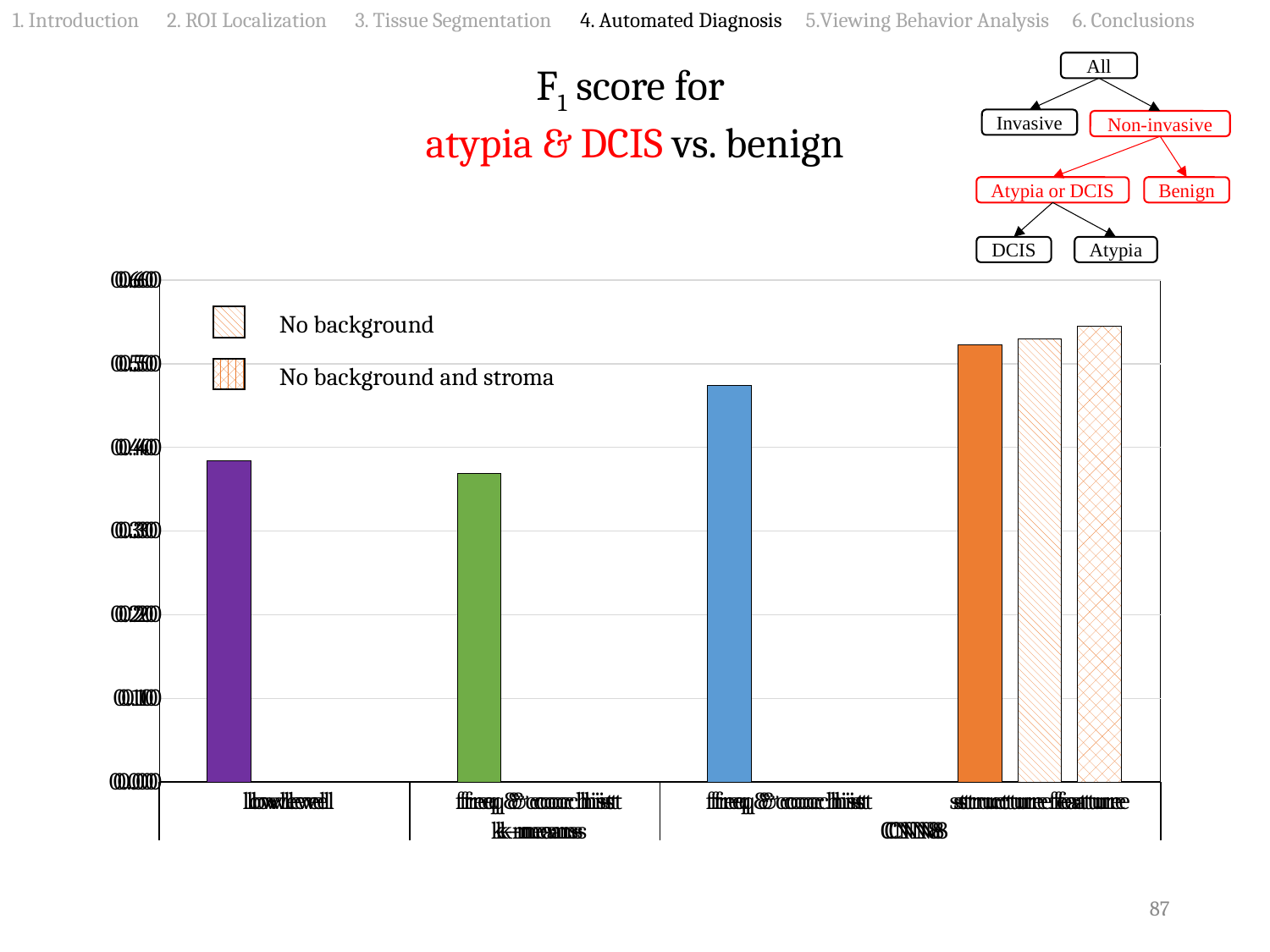
Is the solid bar for structure feature greater or less than 0.50? greater Which category has the highest bar in the chart? structure feature What kind of chart is shown on the slide? bar chart What are the two entries listed in the chart's legend? No background; No background and stroma How many entries does the chart's legend list? 2 Is the value for low level greater or less than 0.30? greater Is the value for freq & cooc hist k-means greater or less than 0.40? less Which is larger, the value for structure feature or the value for low level? structure feature Which is larger, the value for freq & cooc hist CNN or the value for freq & cooc hist k-means? freq & cooc hist CNN How many categories are shown along the x axis of the chart? 4